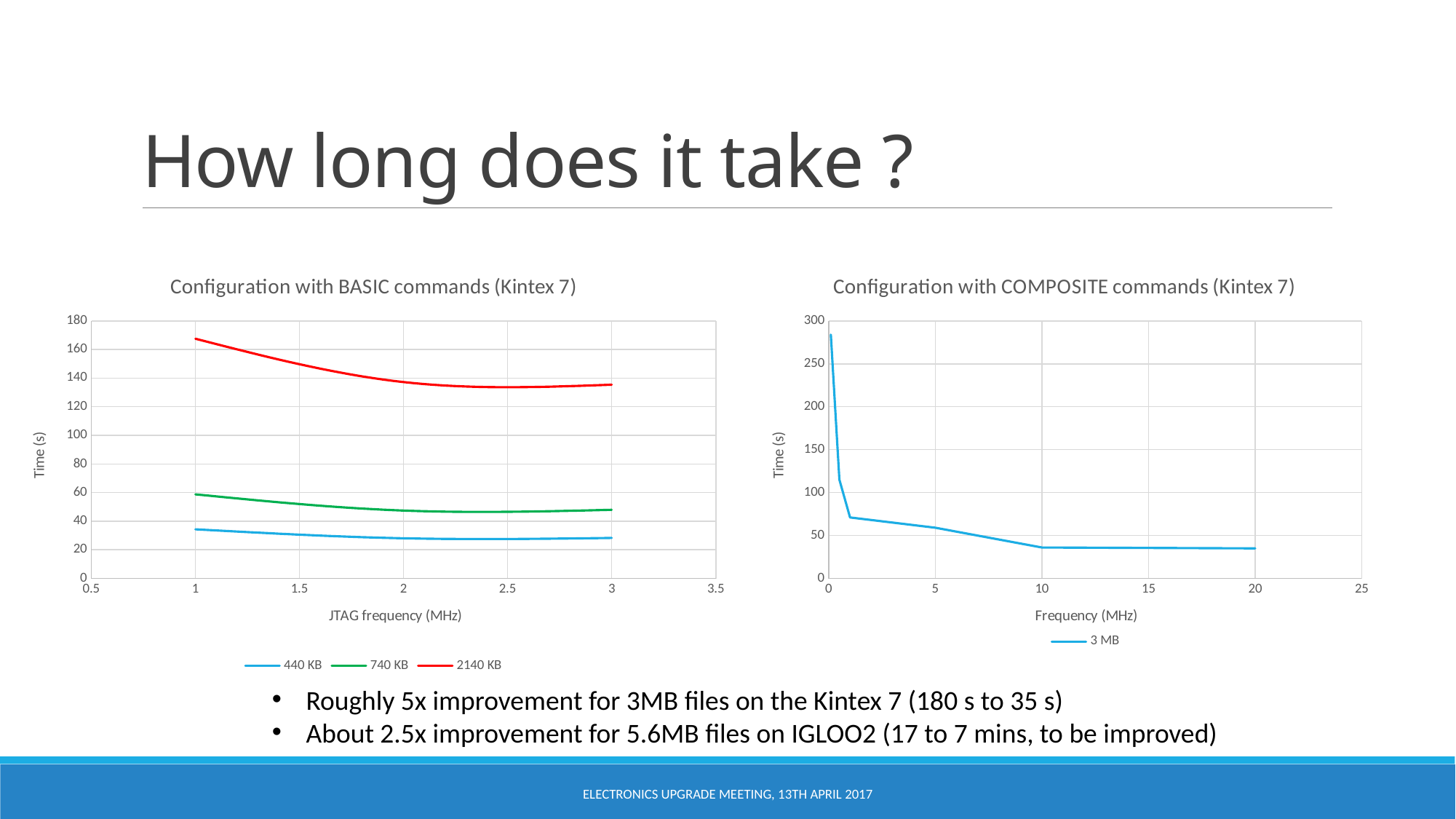
What is the x-axis label of "Configuration with BASIC commands (Kintex 7)"? JTAG frequency (MHz) How many series does the legend of "Configuration with COMPOSITE commands (Kintex 7)" list? 1 In "Configuration with BASIC commands (Kintex 7)", which series has the lowest time values? 440 KB In "Configuration with BASIC commands (Kintex 7)", which series has the highest time values? 2140 KB In "Configuration with BASIC commands (Kintex 7)", does the 2140 KB line rise or fall between 1 MHz and 2 MHz? fall In "Configuration with BASIC commands (Kintex 7)", is the time for 2140 KB at 1 MHz greater or less than 160? greater In "Configuration with COMPOSITE commands (Kintex 7)", is the time for 3 MB at 10 MHz greater or less than 50? less In "Configuration with BASIC commands (Kintex 7)", is the time for 440 KB at 1 MHz greater or less than 40? less What kind of chart is "Configuration with BASIC commands (Kintex 7)"? line chart What series name appears in the legend of "Configuration with COMPOSITE commands (Kintex 7)"? 3 MB How many series does the legend of "Configuration with BASIC commands (Kintex 7)" list? 3 In "Configuration with COMPOSITE commands (Kintex 7)", does the 3 MB line rise or fall as frequency increases from 0 to 10 MHz? fall